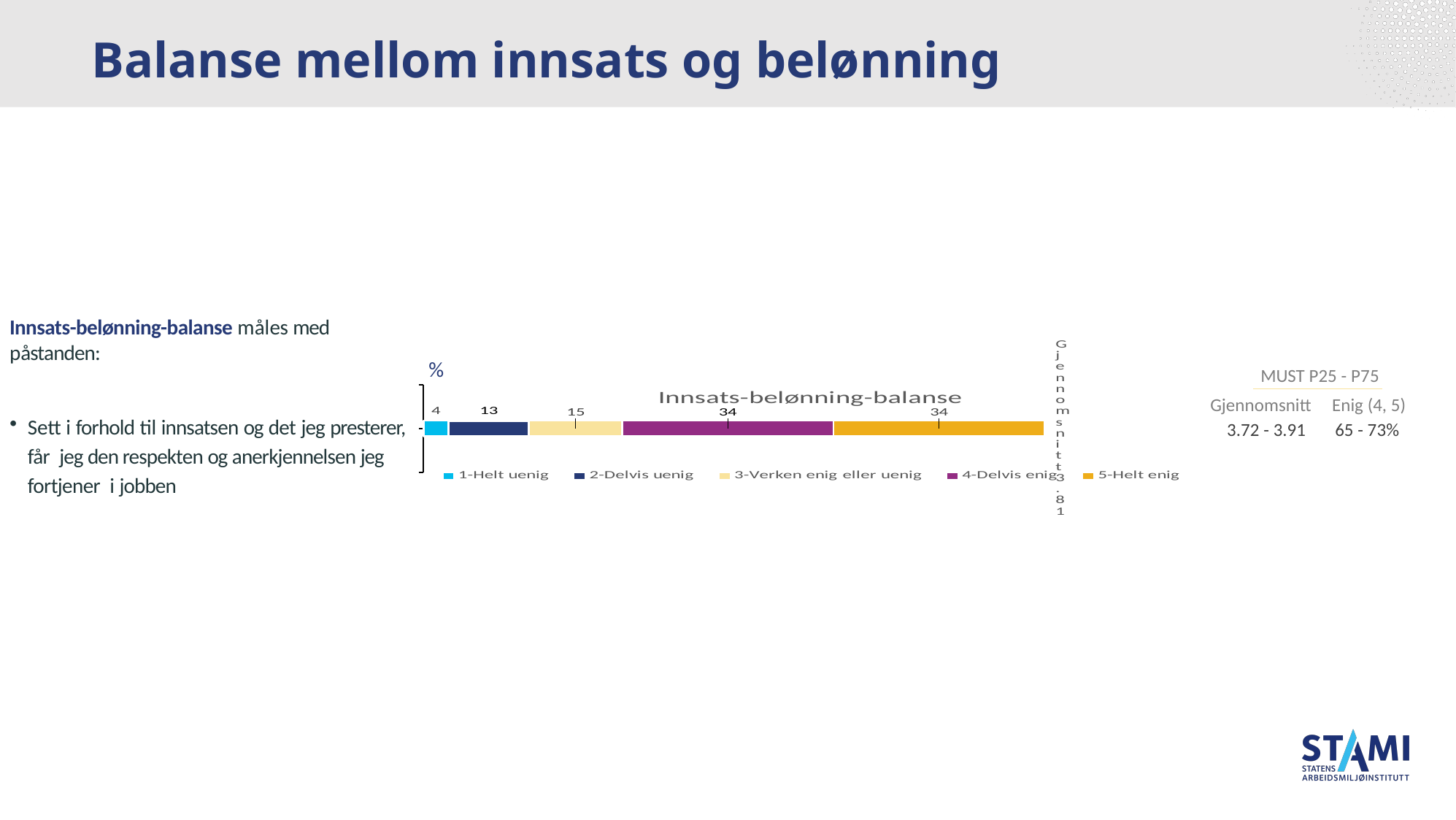
What is the value for 5-Helt enig? 34 What is the difference between the values for 4-Delvis enig and 2-Delvis uenig? 21 How many series does the chart legend list? 5 What kind of chart is shown on the slide? Bar chart What is the total of all segments in the stacked bar? 100 What is the title of the chart? Innsats-belønning-balanse Which is larger, the value for 3-Verken enig eller uenig or the value for 2-Delvis uenig? 3-Verken enig eller uenig Which response category has the lowest value? 1-Helt uenig What is the value for 3-Verken enig eller uenig? 15 What is the value for 2-Delvis uenig? 13 What is the value for 4-Delvis enig? 34 What is the value for 1-Helt uenig? 4